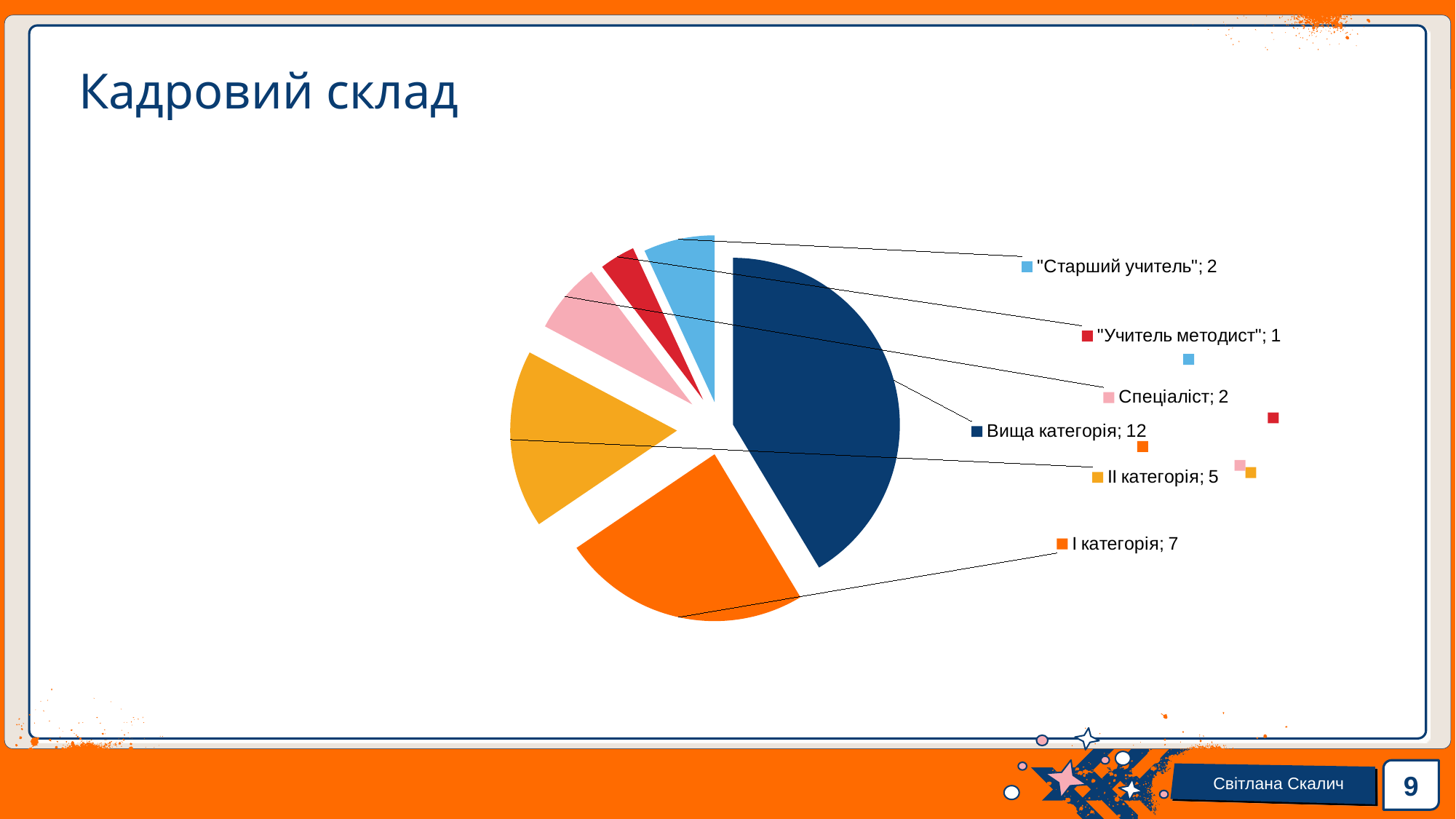
What is the value for Вища категорія? 12 Which category has the largest slice of the pie? Вища категорія What kind of chart is shown on the slide? pie chart Which is larger, the value for ІІ категорія or the value for Спеціаліст? ІІ категорія What is the value for ІІ категорія? 5 What is the value for "Учитель методист"? 1 What is the title of the slide containing the chart? Кадровий склад What is the total of all the values shown in the pie chart? 29 What is the value for І категорія? 7 Which category has the smallest slice of the pie? "Учитель методист" What is the difference between the values for Вища категорія and І категорія? 5 How many slices does the pie chart have? 6